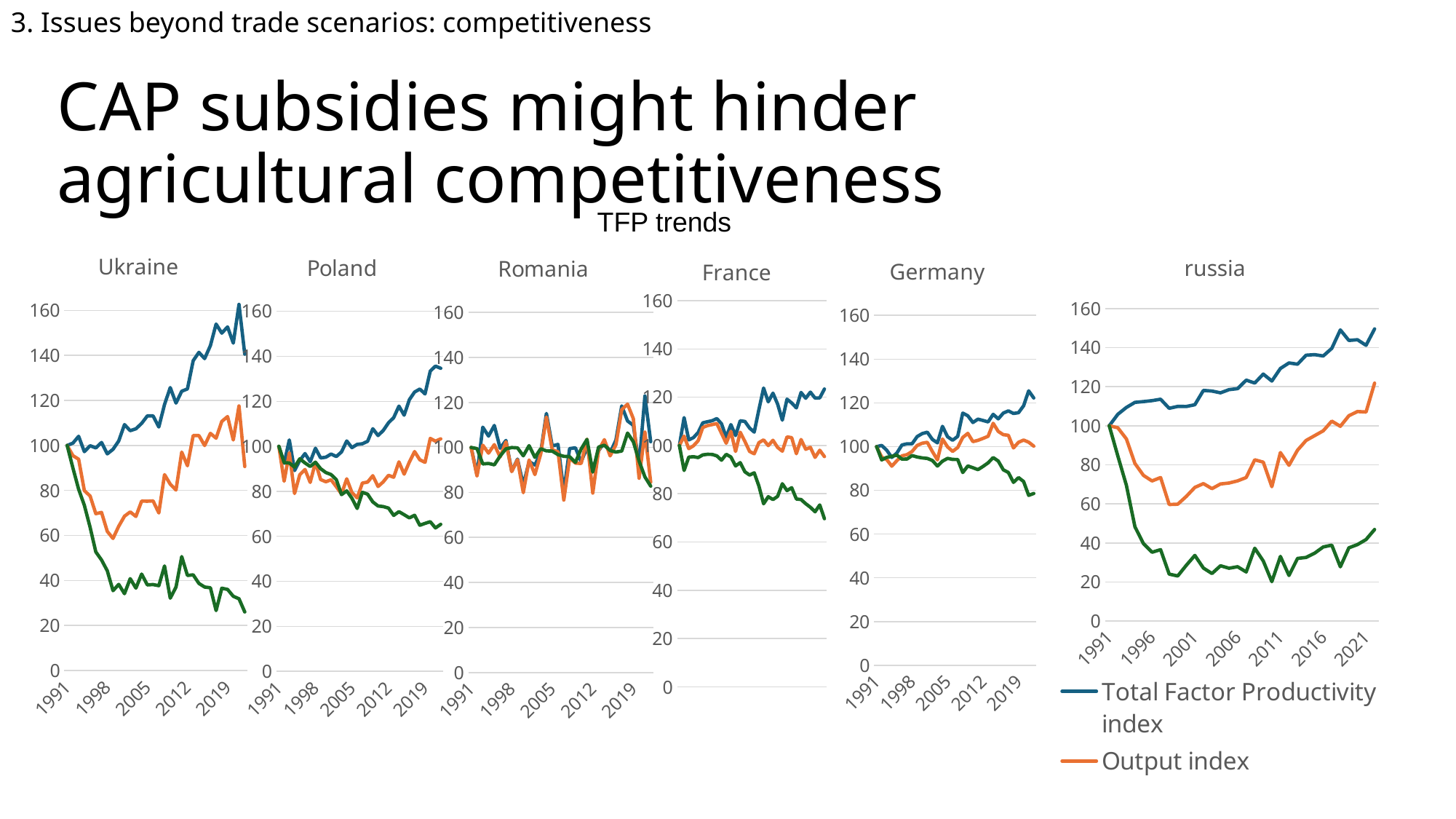
How many series does the legend list? 2 What type of chart is used for the Ukraine panel? line chart What is the overall title shown above the six country charts? TFP trends How many country panels are shown under the 'TFP trends' title? 6 In the Poland chart, does the green line rise or fall over the period shown? fall In the Poland chart, is the final value of the Total Factor Productivity index greater or less than 120? greater In the Ukraine chart, does the Total Factor Productivity index rise or fall from 1991 to the end of the series? rise In the Germany chart, does the Total Factor Productivity index rise or fall over the period shown? rise In the Ukraine chart, is the final value of the green line greater or less than 40? less In the russia chart, is the final value of the Total Factor Productivity index greater or less than 140? greater